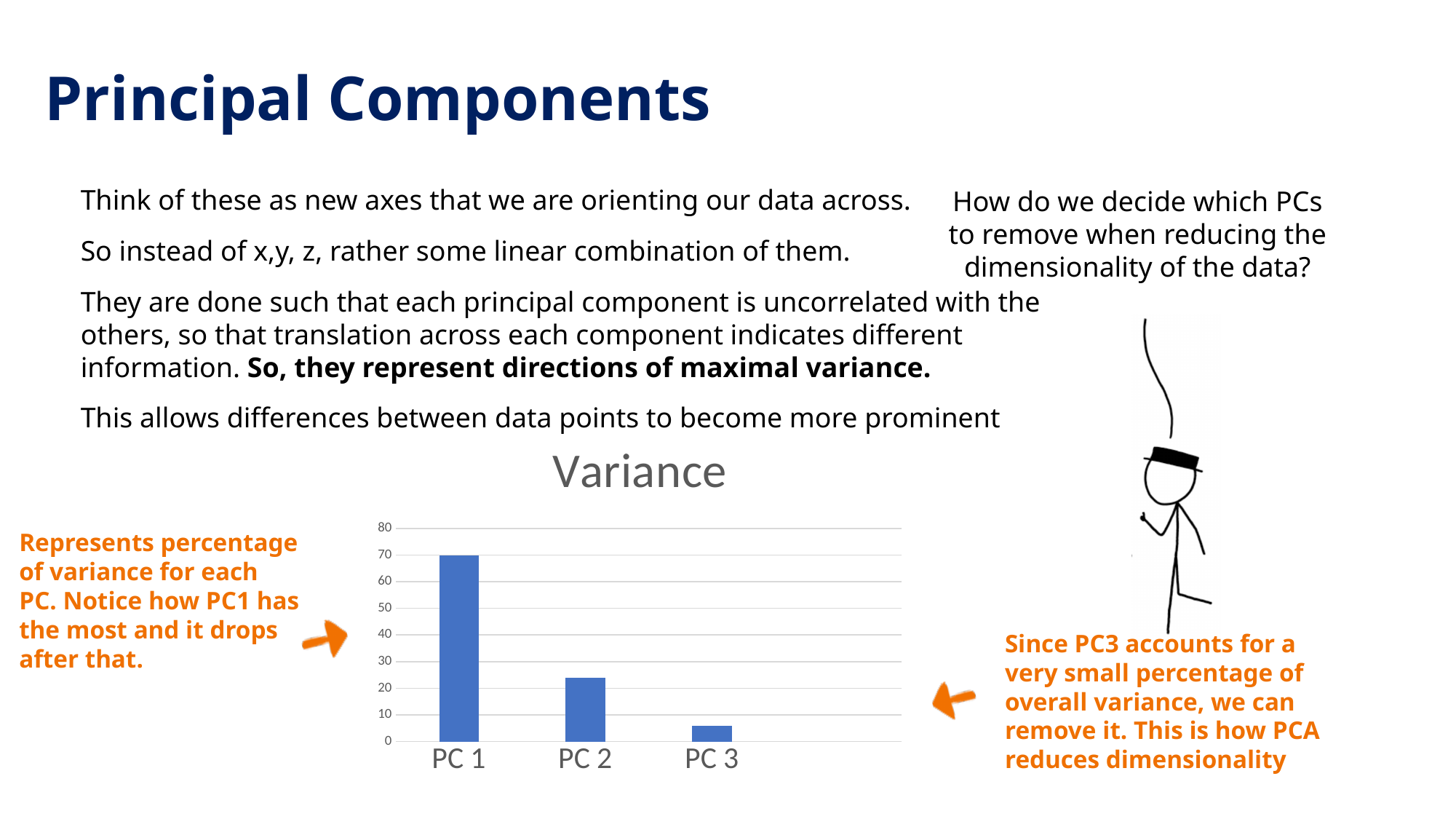
Which is larger, the value for PC 2 or the value for PC 3? PC 2 Which principal component has the lowest variance in the chart? PC 3 What kind of chart is shown on the slide? bar chart What is the title of the chart? Variance Is the value for PC 1 greater or less than 60? greater Which principal component has the highest variance in the chart? PC 1 Is the value for PC 2 greater or less than 30? less Do the values rise or fall from PC 1 to PC 3 along the x axis? fall Is the value for PC 3 greater or less than 10? less What is the value for PC 1 in the Variance chart? 70 How many categories are plotted on the x axis of the Variance chart? 3